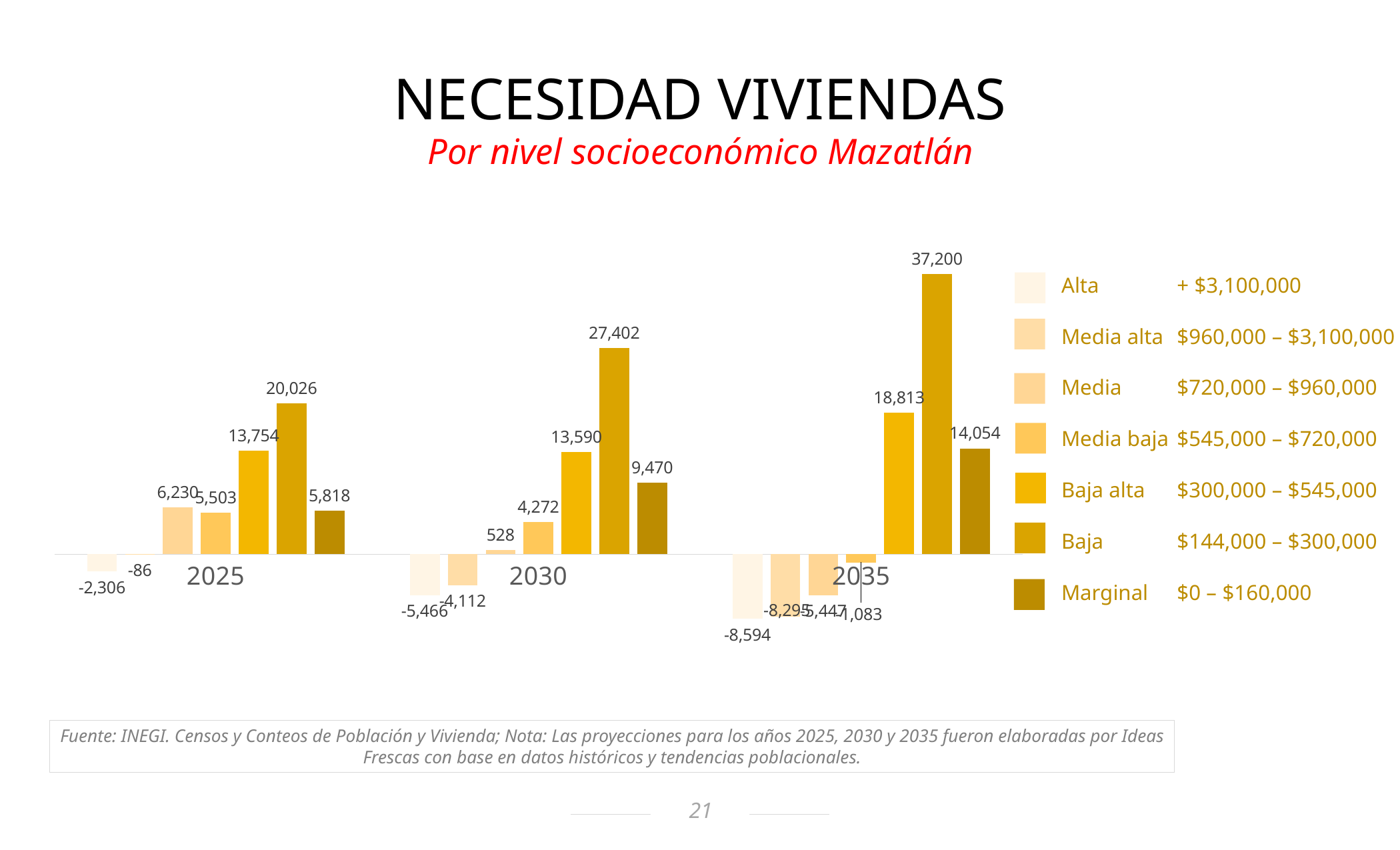
What kind of chart is shown? bar chart What price range does the legend give for Baja alta? $300,000 – $545,000 Which is larger, the Marginal value in 2025 or the Marginal value in 2035? 2035 How many series does the legend list? 7 Which year has the highest value for Baja? 2035 What is the value for Alta in 2030? -5,466 How many year groups are shown on the x axis? 3 What is the value for Marginal in 2030? 9,470 Which series has the lowest value in 2035? Alta What is the value for Baja alta in 2025? 13,754 What is the difference between the Baja values for 2035 and 2030? 9,798 What is the value for Baja in 2035? 37,200